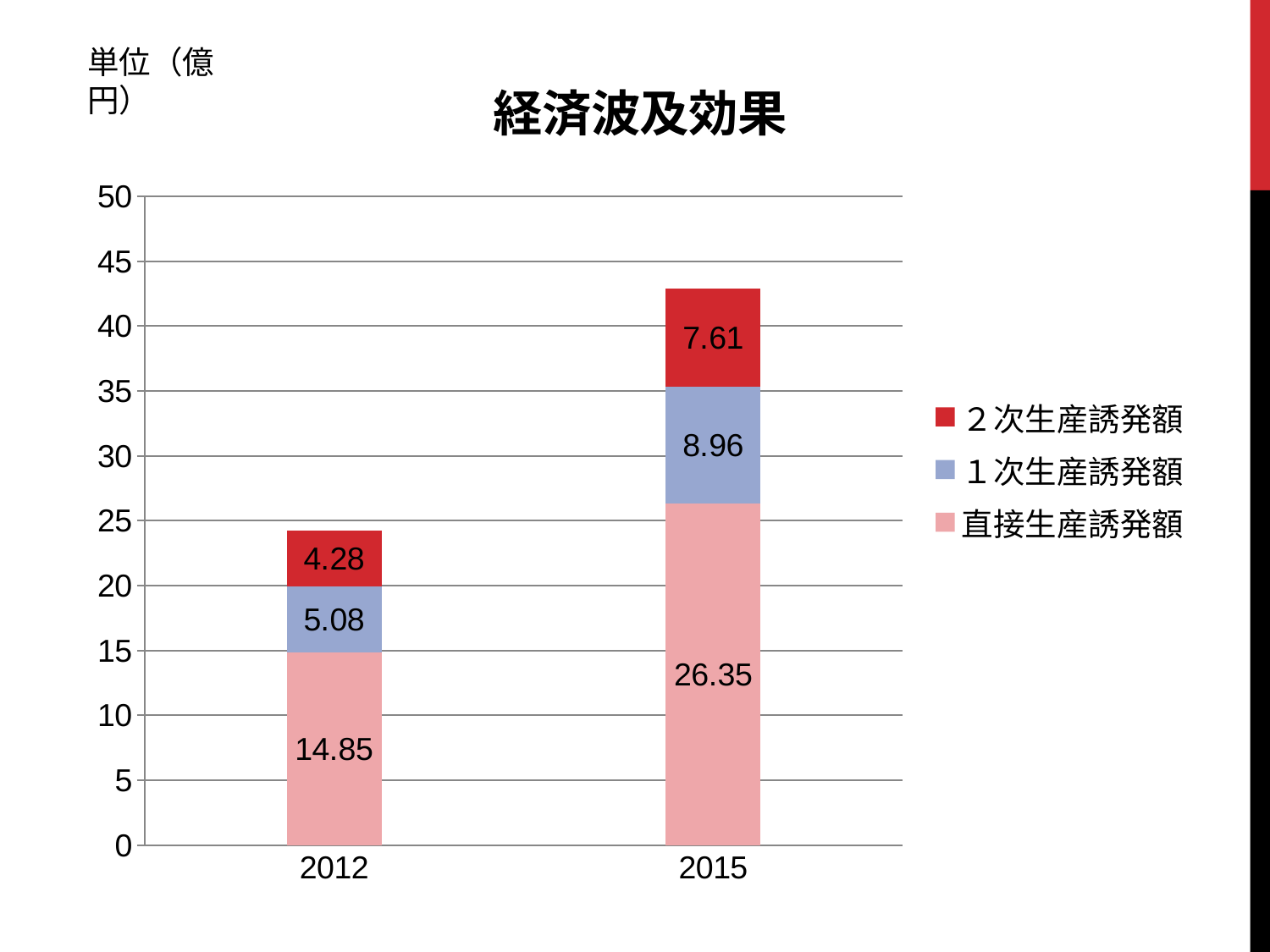
Which year has the larger value for 2次生産誘発額, 2012 or 2015? 2015 How much larger is 直接生産誘発額 in 2015 than in 2012? 11.50 What is the value of 2次生産誘発額 for 2015? 7.61 Is the total of the 2015 bar greater or less than 40? greater What is the title of the chart? 経済波及効果 What is the total of the stacked bar for 2015? 42.92 How many series does the legend list? 3 What is the total of the stacked bar for 2012? 24.21 What is the value of 直接生産誘発額 for 2012? 14.85 What is the value of 1次生産誘発額 for 2012? 5.08 What is the difference between 1次生産誘発額 in 2015 and in 2012? 3.88 What kind of chart is shown on the slide? Stacked bar chart